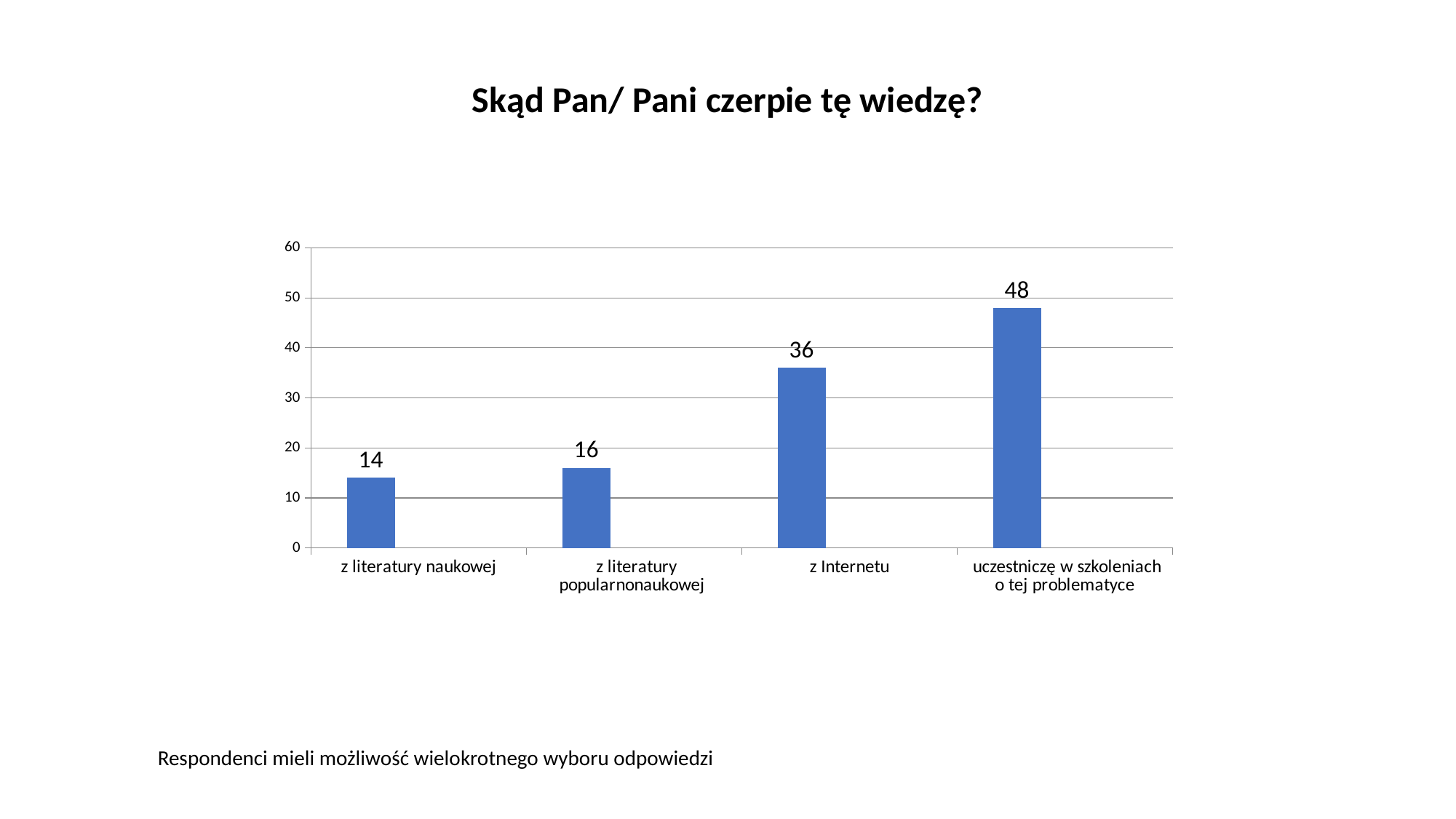
What is the value for "uczestniczę w szkoleniach o tej problematyce"? 48 Which category has the lowest value? z literatury naukowej What is the difference between the values for "uczestniczę w szkoleniach o tej problematyce" and "z Internetu"? 12 What is the title of the chart? Skąd Pan/ Pani czerpie tę wiedzę? What is the value for "z literatury naukowej"? 14 What is the difference between the values for "z literatury popularnonaukowej" and "z literatury naukowej"? 2 What is the value for "z Internetu"? 36 Which is larger, the value for "z Internetu" or the value for "z literatury popularnonaukowej"? z Internetu Which category has the highest value? uczestniczę w szkoleniach o tej problematyce How many categories are shown on the chart? 4 Is the value for "z Internetu" greater or less than 30? greater What kind of chart is shown on the slide? bar chart